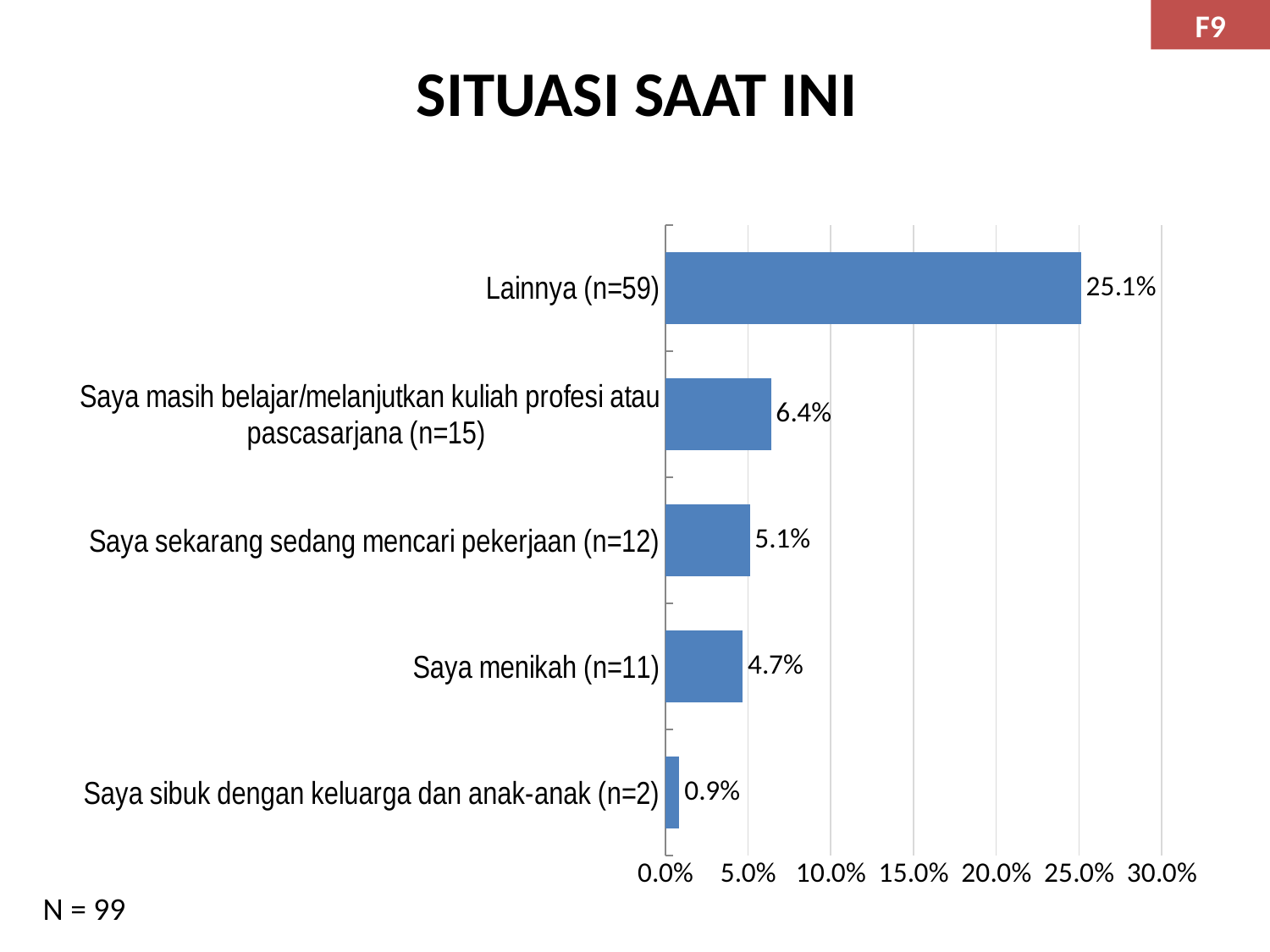
What is the value for "Lainnya (n=59)"? 25.1% What is the value for "Saya masih belajar/melanjutkan kuliah profesi atau pascasarjana (n=15)"? 6.4% What kind of chart is shown on the slide? bar chart What is the difference between the values for "Lainnya (n=59)" and "Saya menikah (n=11)"? 20.4% Which is larger: the value for "Saya sekarang sedang mencari pekerjaan (n=12)" or "Saya menikah (n=11)"? Saya sekarang sedang mencari pekerjaan (n=12) Which category has the highest value? Lainnya (n=59) What is the value for "Saya sibuk dengan keluarga dan anak-anak (n=2)"? 0.9% What is the value for "Saya menikah (n=11)"? 4.7% How many categories are shown in the chart? 5 What is the value for "Saya sekarang sedang mencari pekerjaan (n=12)"? 5.1% Which category has the lowest value? Saya sibuk dengan keluarga dan anak-anak (n=2) Is the value for "Lainnya (n=59)" greater or less than 20.0%? greater